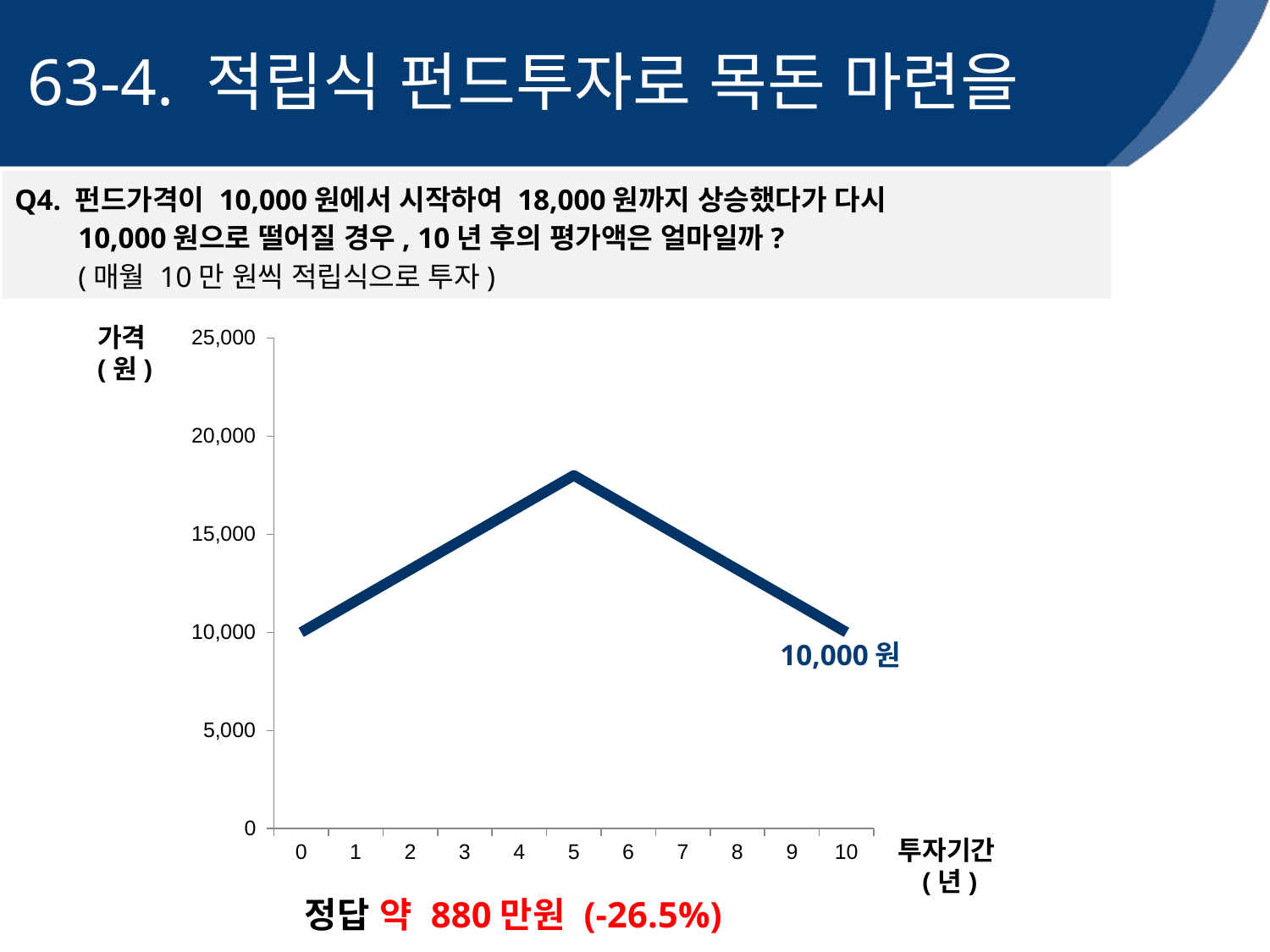
Is the fund price at year 5 greater or less than 15,000? greater How many year ticks are shown on the x axis? 11 What is the label of the x axis? 투자기간 (년) What kind of chart is shown on the slide? line chart What is the highest tick value shown on the y axis? 25,000 Is the fund price at year 5 greater or less than 20,000? less Does the fund price rise or fall between year 5 and year 10? fall What is the fund price at investment year 10 according to the data label? 10,000 원 At which investment year does the fund price reach its highest point? 5 Which is higher, the fund price at year 5 or at year 10? year 5 What is the fund price at investment year 0? 10,000 Does the fund price rise or fall between year 0 and year 5? rise